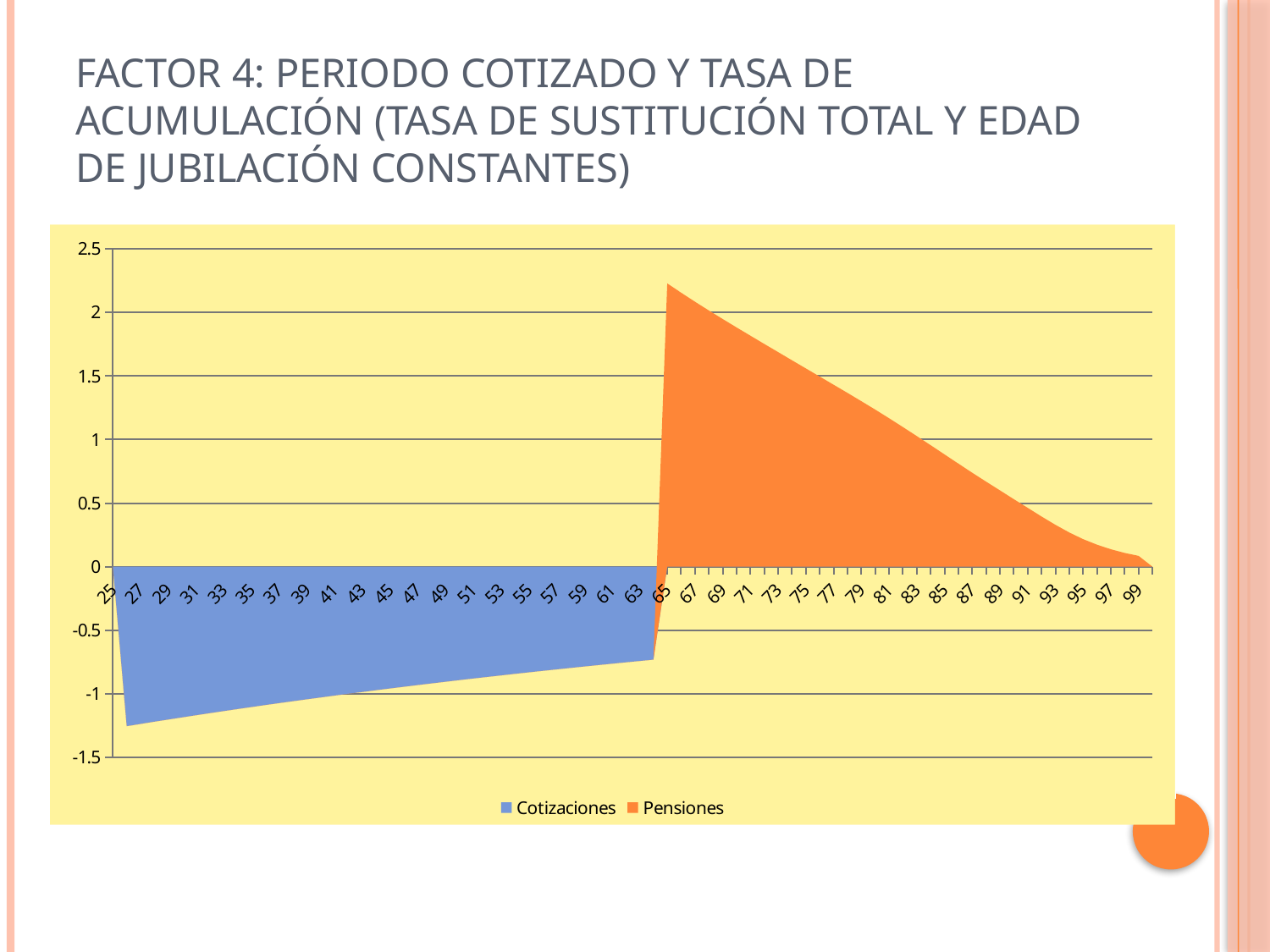
Is the value for Pensiones at age 95 greater or less than 0.5? less What are the two series named in the legend? Cotizaciones and Pensiones Is the value for Cotizaciones at age 63 greater or less than -1? greater Is the value for Cotizaciones at age 25 greater or less than -1? less What is the highest value shown on the vertical axis? 2.5 Do the Pensiones values rise or fall as age increases from 65 to 99? fall Which series has negative values, Cotizaciones or Pensiones? Cotizaciones What kind of chart is shown on the slide? Area chart How many series does the legend list? 2 Do the Cotizaciones values rise or fall as age increases from 25 to 65? rise Which series is drawn in orange? Pensiones